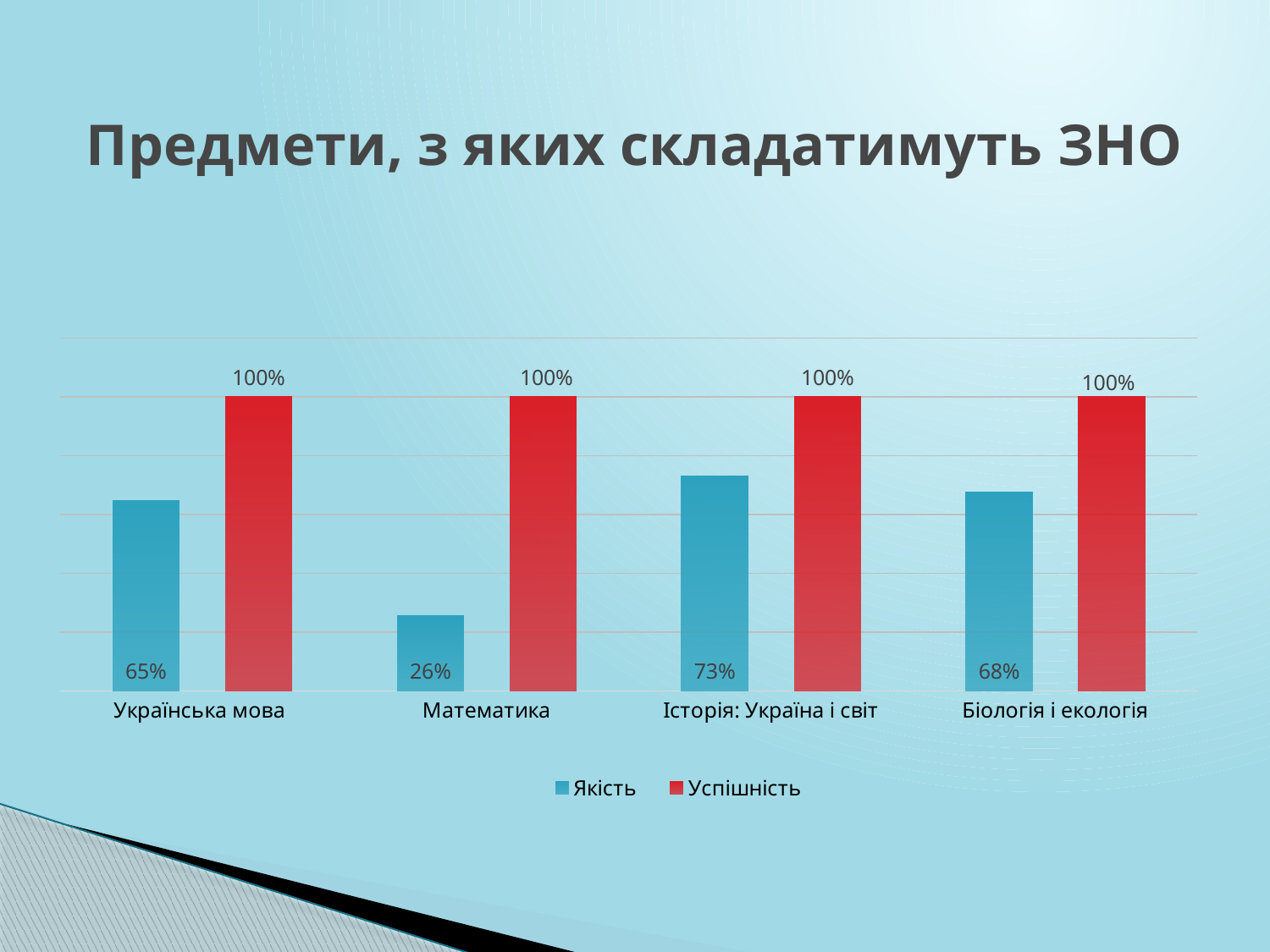
What is the Якість value for Історія: Україна і світ? 73% Which subject has the highest Якість value? Історія: Україна і світ What is the difference between the Якість values for Українська мова and Математика? 39% What is the difference between Успішність and Якість for Біологія і екологія? 32% Which is larger, the Якість value for Українська мова or for Біологія і екологія? Біологія і екологія What is the Успішність value for Біологія і екологія? 100% How many series does the legend list? 2 What kind of chart is shown on the slide? Bar chart What is the Якість value for Математика? 26% How many subjects are shown on the x axis? 4 Which subject has the lowest Якість value? Математика What is the title of the chart? Предмети, з яких складатимуть ЗНО